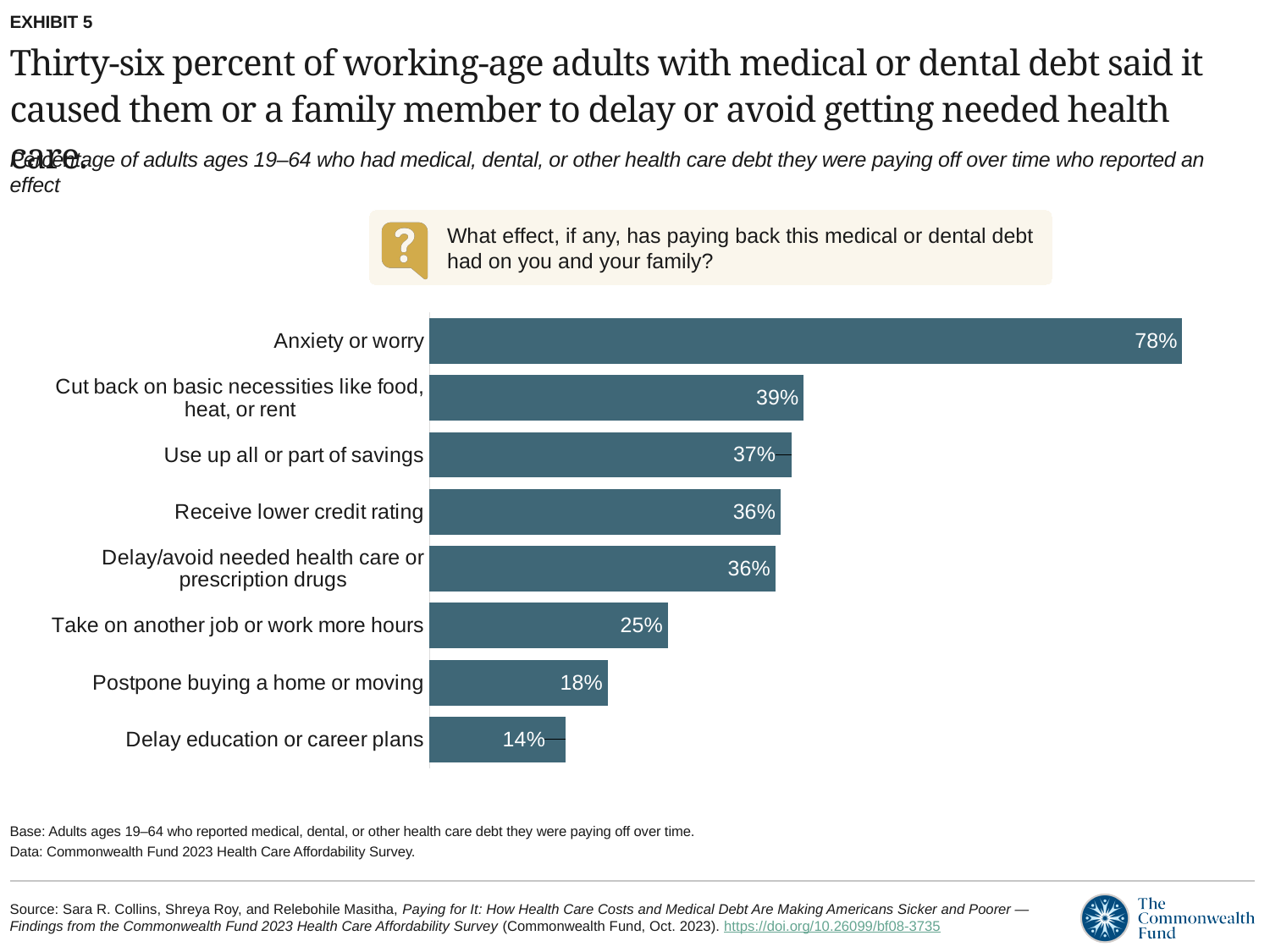
What is the difference in percentage points between 'Anxiety or worry' and 'Cut back on basic necessities like food, heat, or rent'? 39 What percentage of adults reported anxiety or worry as an effect of paying back medical or dental debt? 78% How many effects (categories) are shown in the chart? 8 What percentage reported cutting back on basic necessities like food, heat, or rent? 39% What percentage reported postponing buying a home or moving? 18% Which effect has the highest percentage? Anxiety or worry What question is shown in the box above the chart? What effect, if any, has paying back this medical or dental debt had on you and your family? What is the difference in percentage points between 'Take on another job or work more hours' and 'Delay education or career plans'? 11 What percentage reported taking on another job or working more hours? 25% Which effect has the lowest percentage? Delay education or career plans Which is larger: the percentage for 'Use up all or part of savings' or for 'Receive lower credit rating'? Use up all or part of savings What kind of chart is shown on the slide? Bar chart